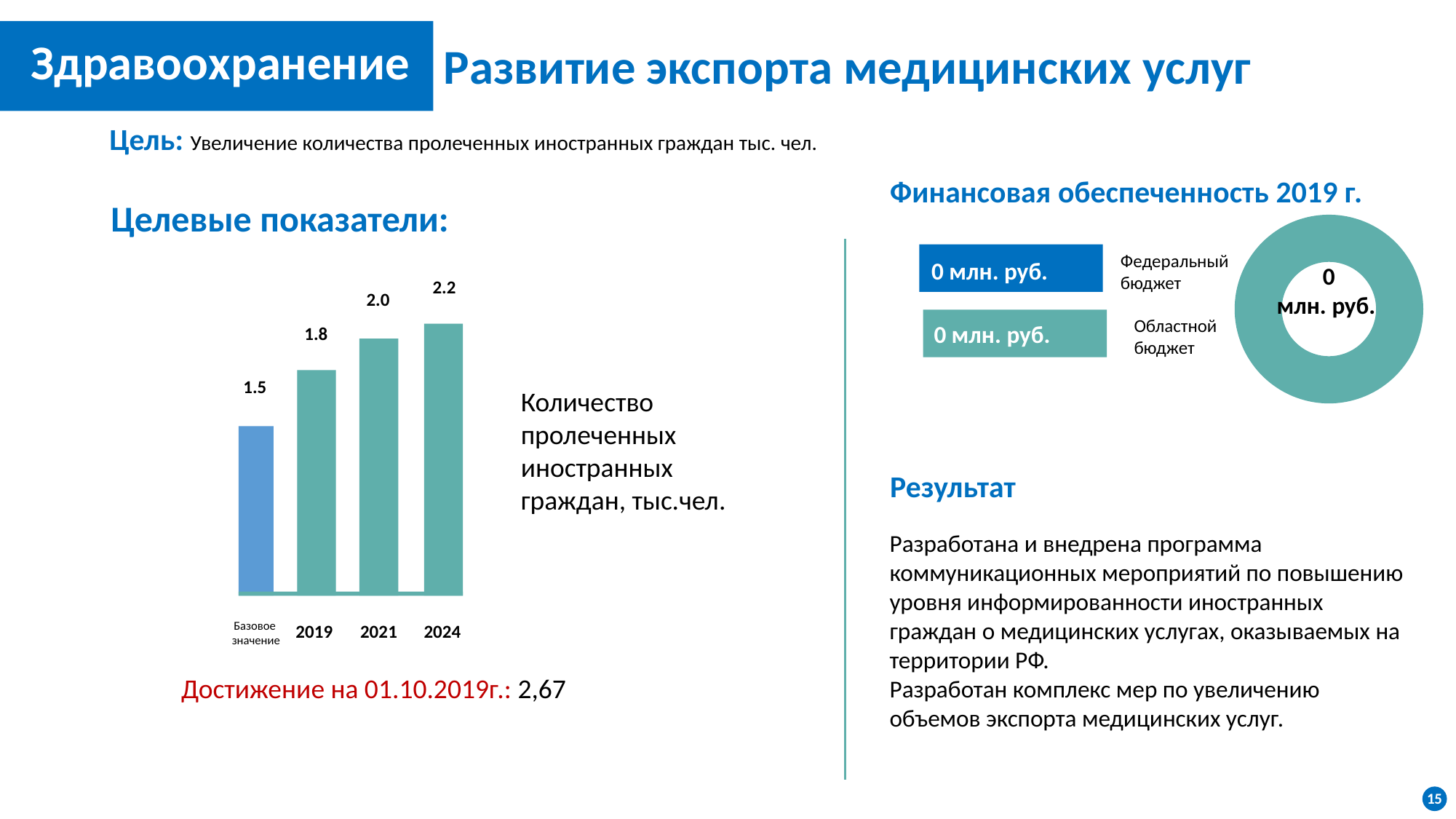
In the bar chart on the left, what is the value for 2024? 2.2 How many bars are in the bar chart on the left? 4 In the bar chart on the left, what is the value for Базовое значение? 1.5 In the bar chart on the left, what is the difference between the values for 2024 and Базовое значение? 0.7 In the bar chart on the left, which is larger: the value for 2019 or the value for 2021? 2021 In the bar chart on the left, which category has the highest value? 2024 In the bar chart on the left, what is the value for 2019? 1.8 In the bar chart on the left, which category has the lowest value? Базовое значение In the bar chart on the left, what is the value for 2021? 2.0 What value is printed in the centre of the donut chart under 'Финансовая обеспеченность 2019 г.'? 0 млн. руб. In the bar chart on the left, do the values rise or fall from Базовое значение to 2024? Rise What kind of chart is shown on the left under 'Целевые показатели'? Bar chart